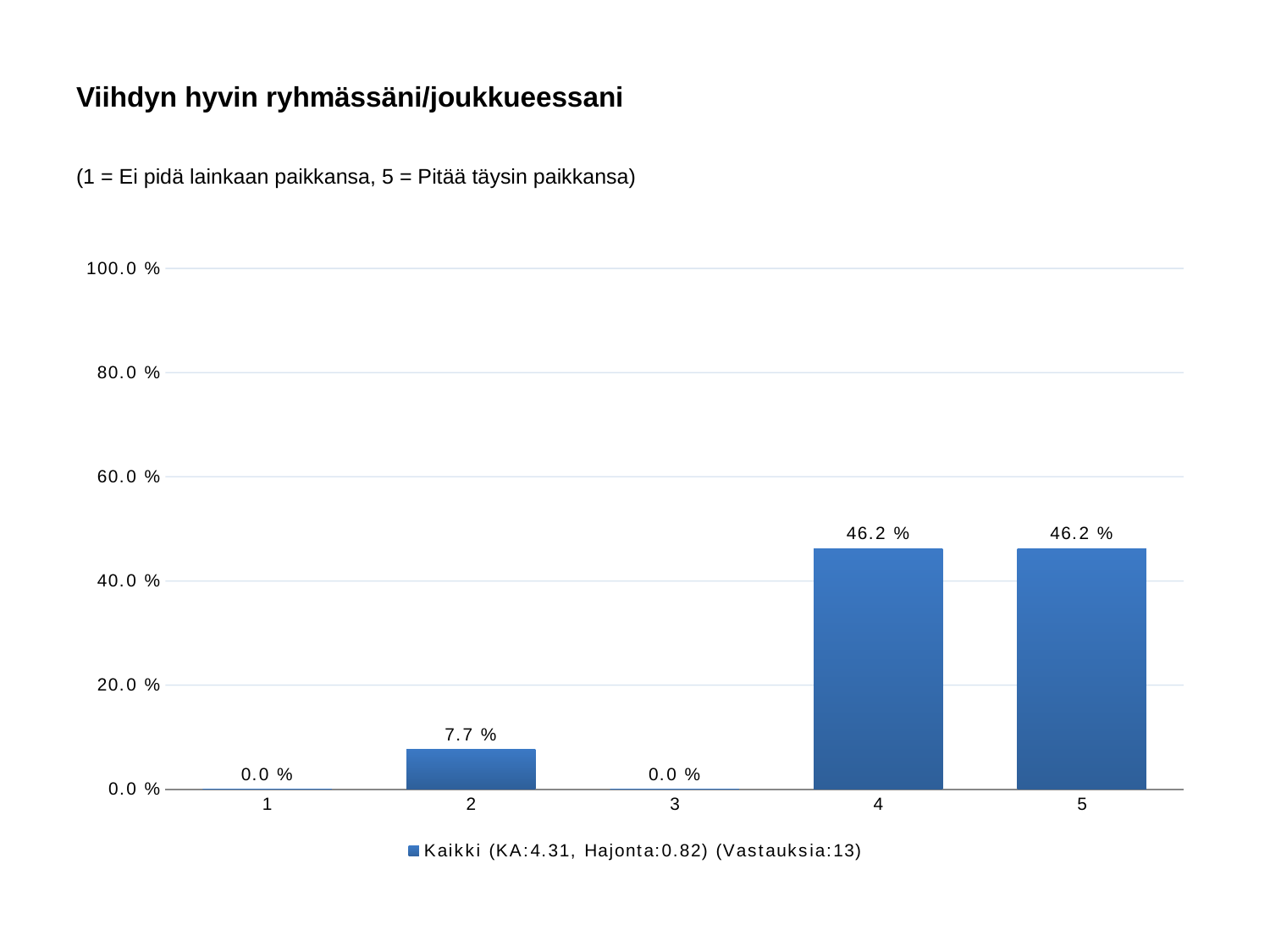
How many categories are shown on the x axis? 5 What is the value for category 5? 46.2 % What kind of chart is shown on the slide? bar chart What is the title of the chart? Viihdyn hyvin ryhmässäni/joukkueessani Is the value for category 5 greater or less than 40.0 %? greater What is the value for category 2? 7.7 % What is the value for category 3? 0.0 % What is the value for category 1? 0.0 % What is the difference between the value for category 4 and the value for category 2? 38.5 % How many series does the legend list? 1 What is the value for category 4? 46.2 % Which is larger, the value for category 2 or the value for category 4? 4